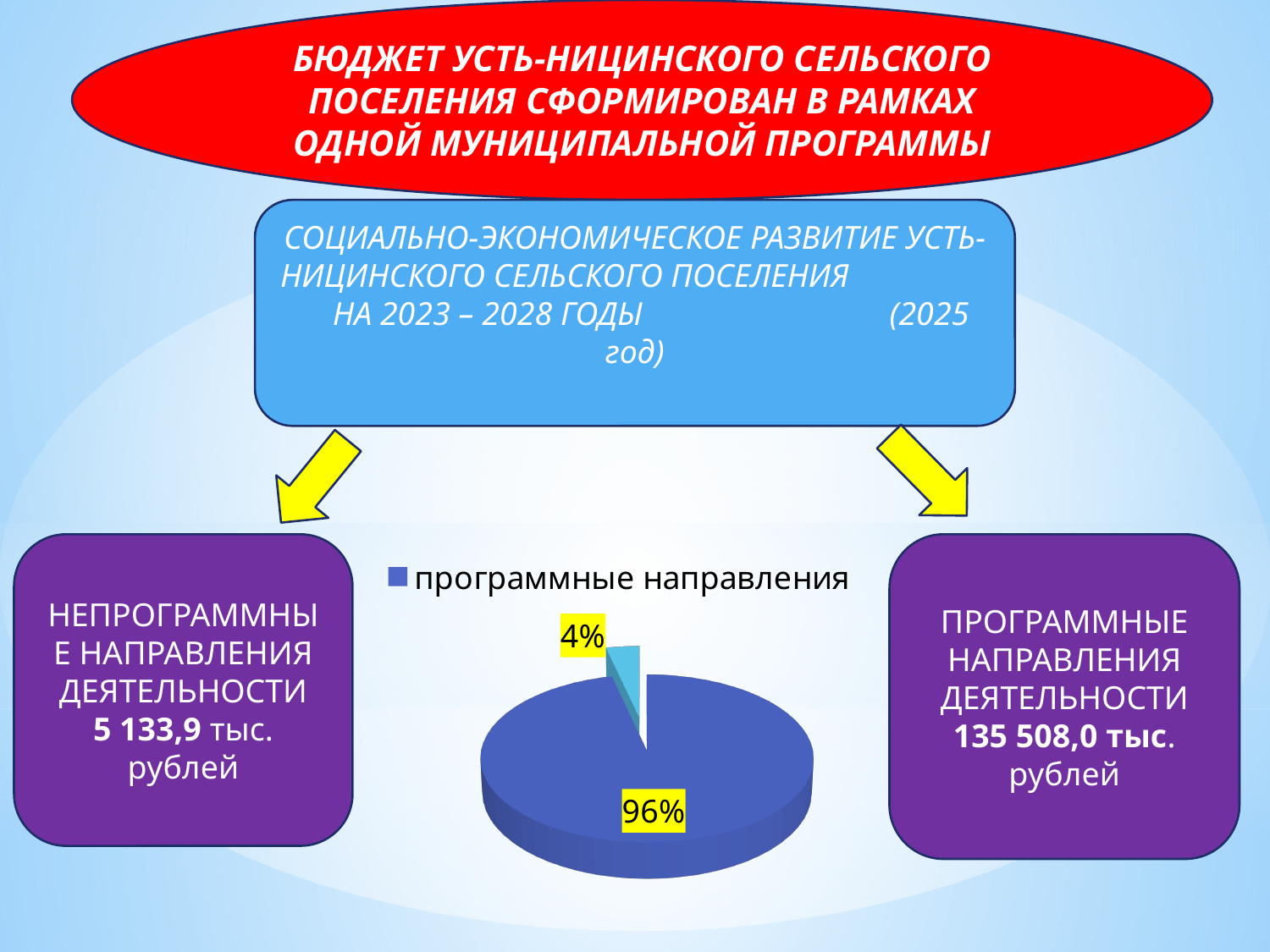
What share of the pie is shown for программные направления? 96% How many slices does the pie chart have? 2 What share of the pie does the smaller slice show? 4% Which slice of the pie is the largest? 96% (программные направления) What colour is the largest slice of the pie chart? blue What kind of chart is shown on the slide? pie chart What is the legend entry shown above the pie chart? программные направления What share of the pie does the larger slice show? 96% What is the difference in percentage points between the two slices of the pie? 92 Which is larger: the 96% slice or the 4% slice? the 96% slice Which slice of the pie is the smallest? 4% How many entries does the chart legend list? 1